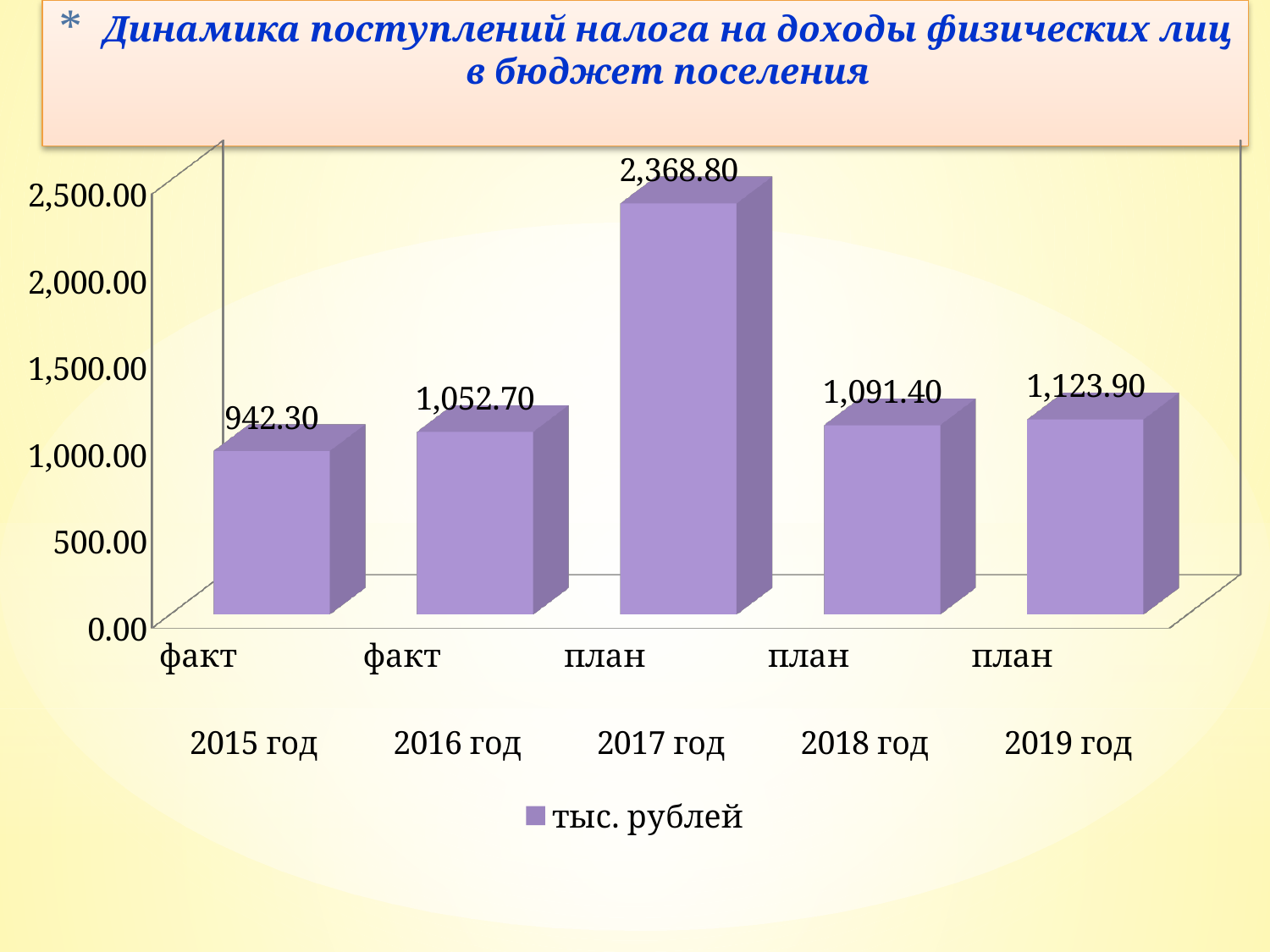
Which year has the highest value? 2017 год What is the value for 2017 год? 2,368.80 Is the value for 2017 год greater or less than 2,000.00? greater What kind of chart is shown on the slide? bar chart What series name does the legend show? тыс. рублей What is the difference between the values for 2019 год and 2018 год? 32.50 Which is larger, the value for 2018 год or the value for 2016 год? 2018 год What is the difference between the values for 2016 год and 2015 год? 110.40 What is the value for 2015 год? 942.30 Which year has the lowest value? 2015 год What is the value for 2019 год? 1,123.90 How many bars are plotted in the chart? 5